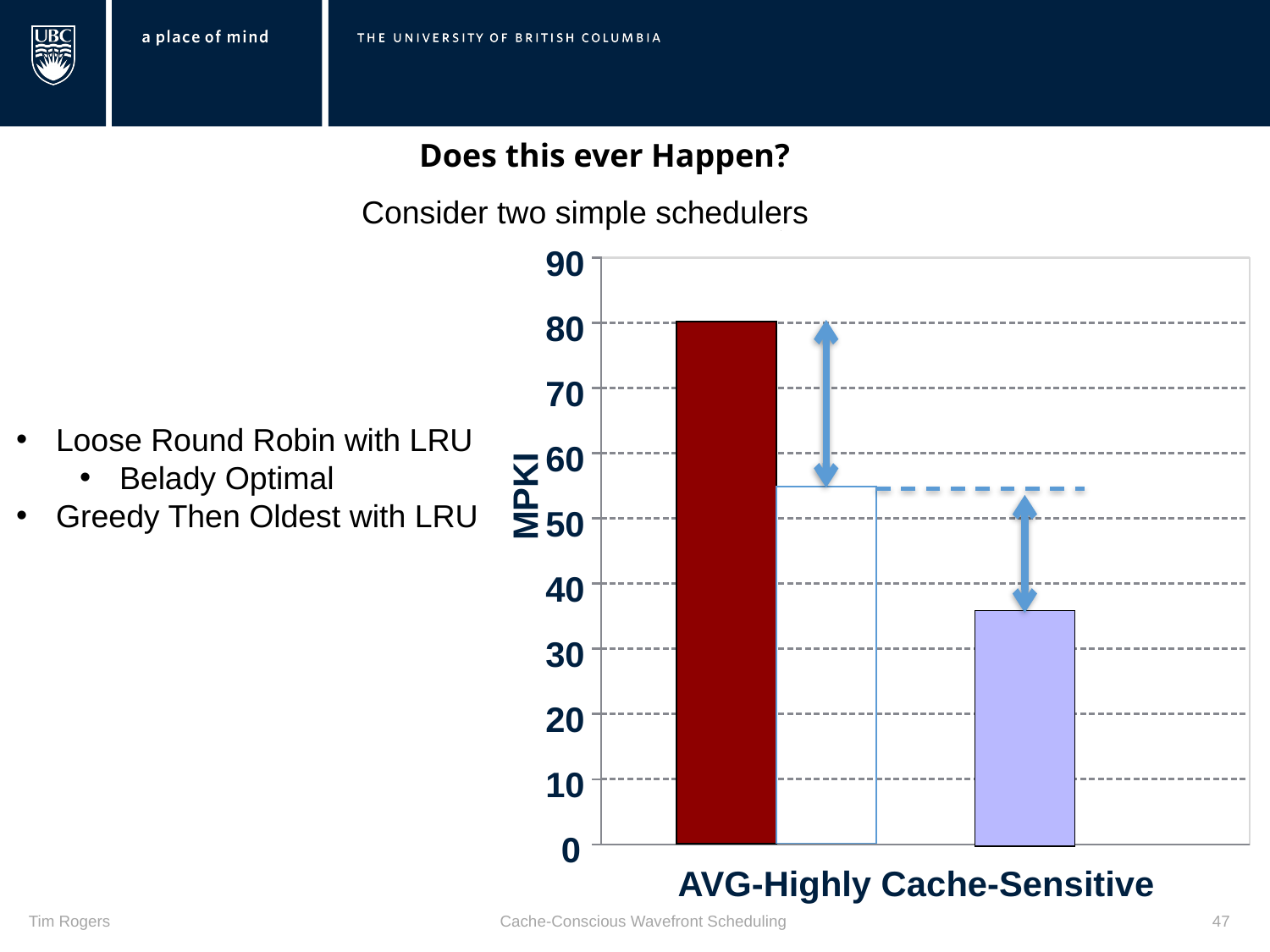
How many bars are plotted in the chart? 3 Is the value of the light blue bar greater or less than 40? less Is the value of the dark red bar greater or less than 70? greater Which bar is the tallest in the chart: the dark red bar, the white outlined bar, or the light blue bar? the dark red bar Is the value of the white outlined bar greater or less than 50? greater What is the category label shown on the horizontal axis of the chart? AVG-Highly Cache-Sensitive What kind of chart is shown on the slide? bar chart What is the label on the vertical axis of the chart? MPKI What is the highest value shown on the vertical axis of the chart? 90 Which is larger: the value of the white outlined bar or the value of the light blue bar? the white outlined bar Which bar is the shortest in the chart: the dark red bar, the white outlined bar, or the light blue bar? the light blue bar